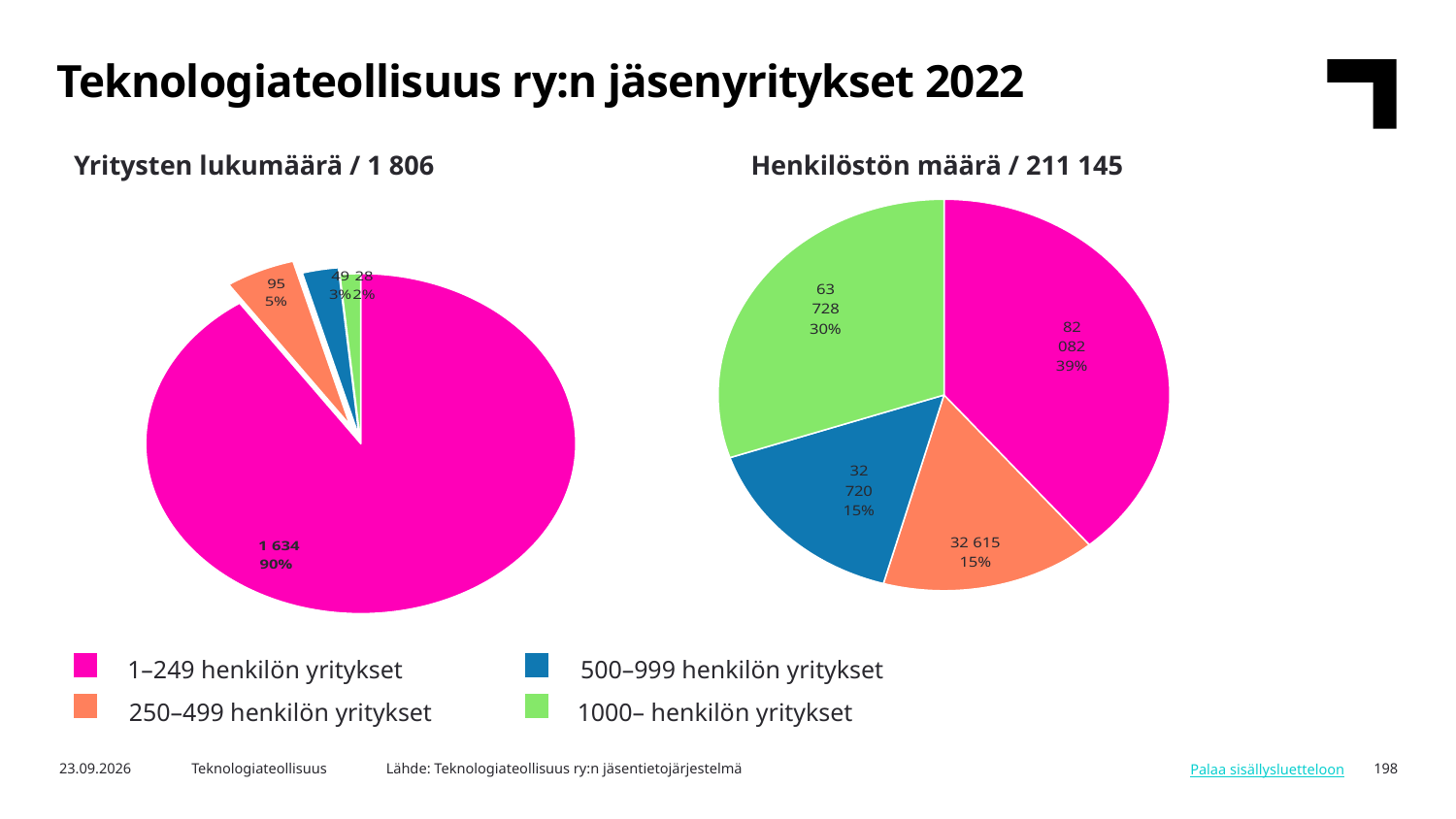
In the 'Henkilöstön määrä / 211 145' chart, which category has the largest slice? 1–249 henkilön yritykset In the 'Yritysten lukumäärä / 1 806' chart, which is larger: the value for 250–499 henkilön yritykset or 500–999 henkilön yritykset? 250–499 henkilön yritykset How many slices does the 'Henkilöstön määrä / 211 145' chart have? 4 Which colour represents 500–999 henkilön yritykset in the legend? Blue In the 'Henkilöstön määrä / 211 145' chart, what is the difference between the values for 1–249 henkilön yritykset and 1000– henkilön yritykset? 18 354 What type of chart is used for 'Yritysten lukumäärä / 1 806'? Pie chart In the 'Yritysten lukumäärä / 1 806' chart, what share of the pie do 250–499 henkilön yritykset have? 5% In the 'Yritysten lukumäärä / 1 806' chart, what is the value for 1–249 henkilön yritykset? 1 634 In the 'Yritysten lukumäärä / 1 806' chart, which category has the smallest slice? 1000– henkilön yritykset In the 'Henkilöstön määrä / 211 145' chart, what share of the pie do 1–249 henkilön yritykset have? 39% In the 'Henkilöstön määrä / 211 145' chart, what is the value for 1000– henkilön yritykset? 63 728 In the 'Henkilöstön määrä / 211 145' chart, what is the value for 250–499 henkilön yritykset? 32 615